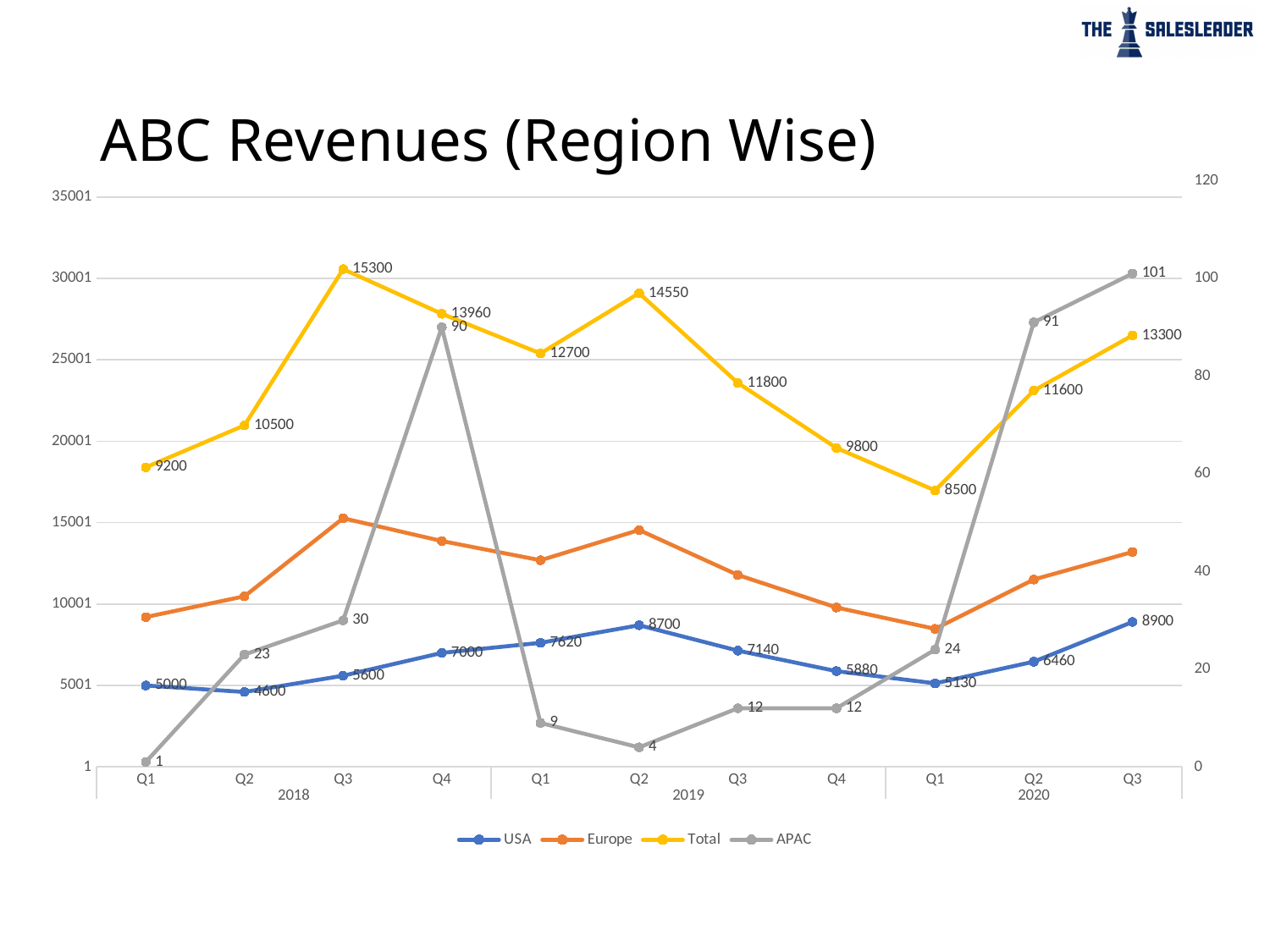
What is the lowest labelled value of the Total series? 8500 What is the highest labelled value of the APAC series? 101 How many quarters are plotted along the x axis? 11 In which quarter does the Total series reach its highest labelled value? Q3 2018 What is the Total value for Q2 2019? 14550 Which is larger, the USA value for Q2 2019 or the USA value for Q3 2020? Q3 2020 What is the difference between the Total values for Q3 2018 and Q2 2018? 4800 How many series does the legend list? 4 What is the APAC value for Q4 2018? 90 Does the Total series rise or fall from Q2 2019 to Q1 2020? Fall What kind of chart is shown on the slide? Line chart What is the USA value for Q1 2018? 5000